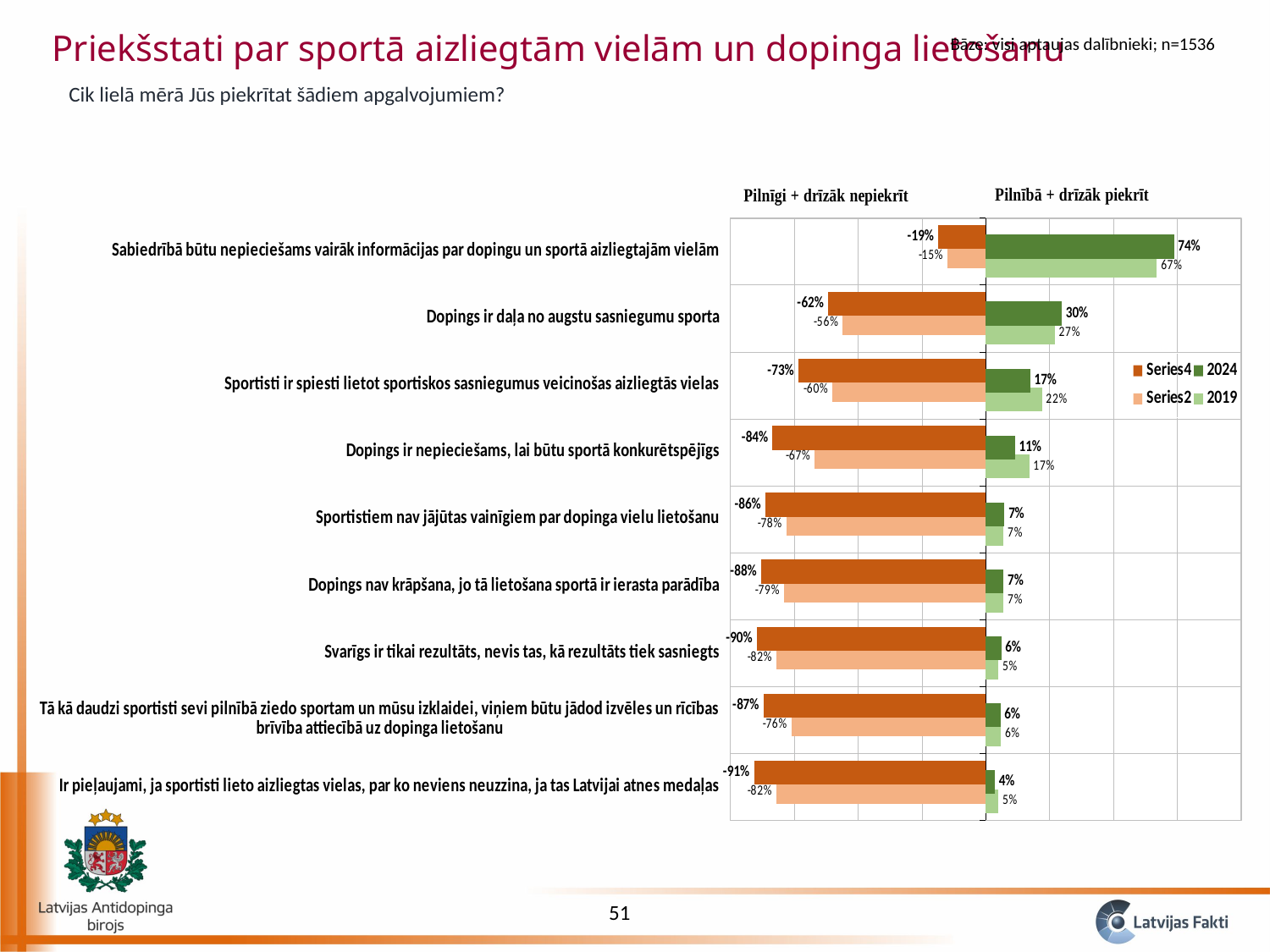
For "Sportisti ir spiesti lietot sportiskos sasniegumus veicinošas aizliegtās vielas", which year has the larger agreement value, 2024 or 2019? 2019 What kind of chart is shown on the slide? Bar chart What is the 2024 agreement value (Pilnībā + drīzāk piekrīt) for "Sabiedrībā būtu nepieciešams vairāk informācijas par dopingu un sportā aizliegtajām vielām"? 74% What is the 2024 agreement value for "Svarīgs ir tikai rezultāts, nevis tas, kā rezultāts tiek sasniegts"? 6% How many statements are shown in the chart? 9 What is the 2024 disagreement value (Pilnīgi + drīzāk nepiekrīt) for "Dopings ir nepieciešams, lai būtu sportā konkurētspējīgs"? -84% What is the 2019 disagreement value for "Sportisti ir spiesti lietot sportiskos sasniegumus veicinošas aizliegtās vielas"? -60% Which statement has the highest 2024 agreement value? Sabiedrībā būtu nepieciešams vairāk informācijas par dopingu un sportā aizliegtajām vielām Which statement has the lowest 2024 agreement value? Ir pieļaujami, ja sportisti lieto aizliegtas vielas, par ko neviens neuzzina, ja tas Latvijai atnes medaļas What is the 2019 agreement value for "Dopings ir daļa no augstu sasniegumu sporta"? 27% What is the difference between the 2024 and 2019 agreement values for "Sabiedrībā būtu nepieciešams vairāk informācijas par dopingu un sportā aizliegtajām vielām"? 7 percentage points How many series does the legend list? 4